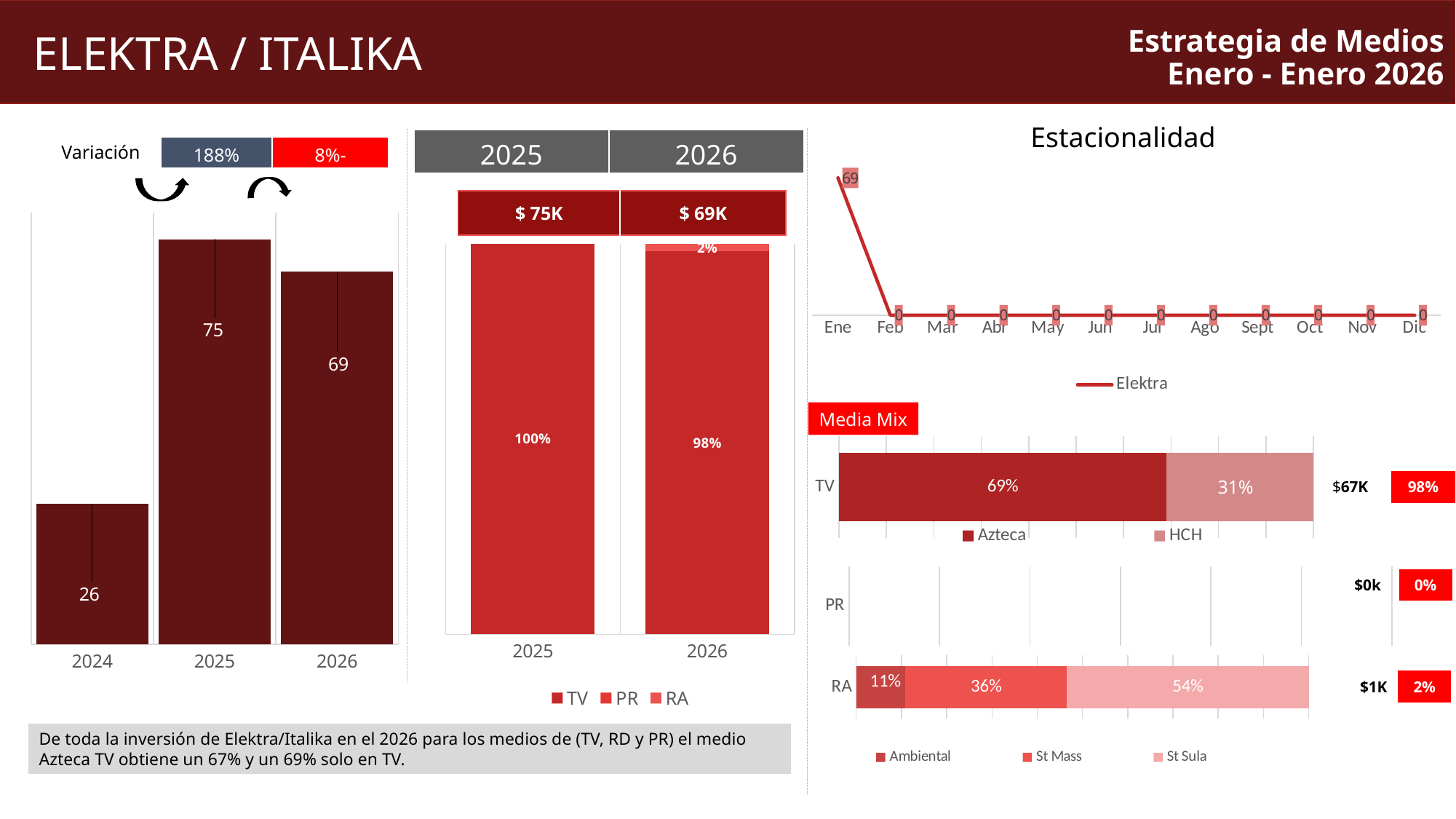
In the bar chart on the left of the slide, which year has the lowest value? 2024 What kind of chart is the Estacionalidad chart? Line chart In the Media Mix chart, what share of TV does Azteca account for? 69% In the stacked bar chart in the middle of the slide, what percentage does TV account for in 2026? 98% In the stacked bar chart in the middle of the slide, how many series does the legend list? 3 In the Media Mix chart, which RA series has the largest share? St Sula In the bar chart on the left of the slide, what is the value for 2025? 75 In the bar chart on the left of the slide, what is the value for 2024? 26 In the Estacionalidad chart, what is the value for Ene? 69 In the bar chart on the left of the slide, which year has the highest value? 2025 In the bar chart on the left of the slide, what is the difference between the values for 2025 and 2026? 6 In the bar chart on the left of the slide, how many years are shown? 3